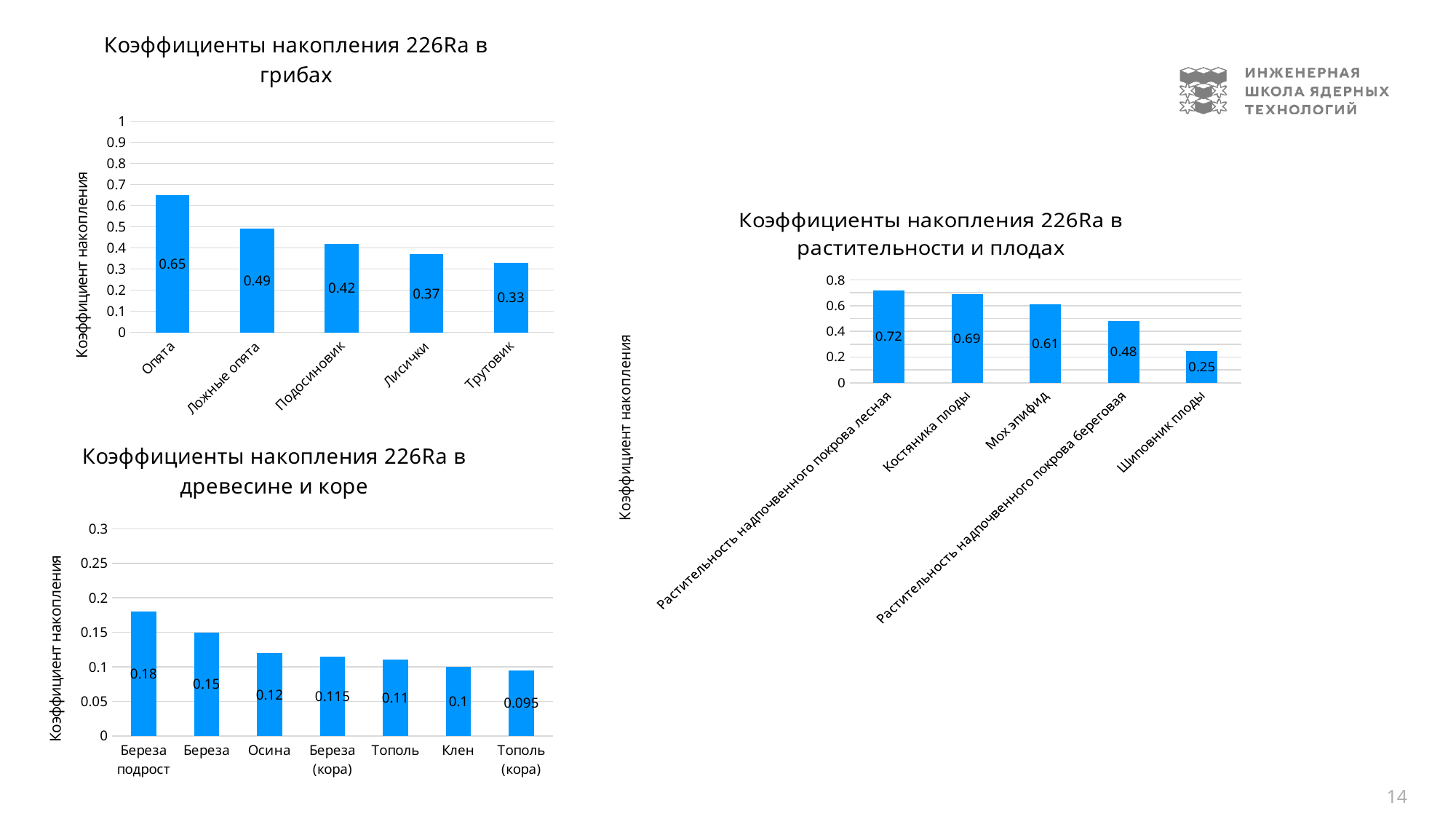
What kind of chart is 'Коэффициенты накопления 226Ra в растительности и плодах'? bar chart In the chart 'Коэффициенты накопления 226Ra в грибах', what is the value for Опята? 0.65 In the chart 'Коэффициенты накопления 226Ra в грибах', which category has the lowest value? Трутовик In the chart 'Коэффициенты накопления 226Ra в растительности и плодах', what is the value for Мох эпифид? 0.61 In the chart 'Коэффициенты накопления 226Ra в древесине и коре', what is the value for Береза (кора)? 0.115 In the chart 'Коэффициенты накопления 226Ra в древесине и коре', how many categories are plotted? 7 In the chart 'Коэффициенты накопления 226Ra в древесине и коре', which category has the highest value? Береза подрост In the chart 'Коэффициенты накопления 226Ra в грибах', how many categories are plotted? 5 In the chart 'Коэффициенты накопления 226Ra в грибах', what is the difference between the values for Опята and Лисички? 0.28 In the chart 'Коэффициенты накопления 226Ra в растительности и плодах', which is larger: Костяника плоды or Шиповник плоды? Костяника плоды In the chart 'Коэффициенты накопления 226Ra в древесине и коре', do the values rise or fall from left to right? fall In the chart 'Коэффициенты накопления 226Ra в растительности и плодах', what is the difference between the values for Растительность надпочвенного покрова лесная and Растительность надпочвенного покрова береговая? 0.24